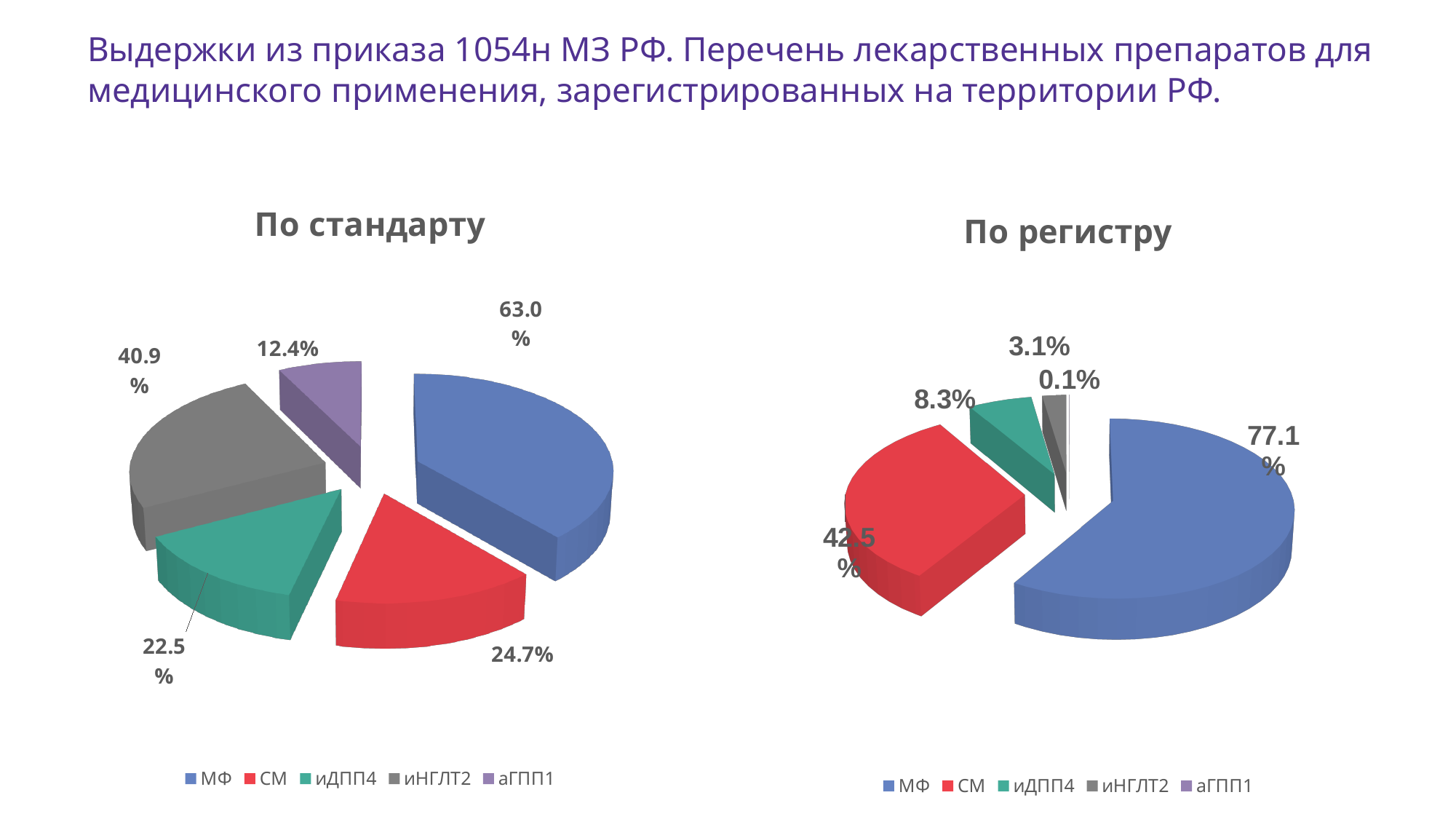
In the chart titled "По регистру", which category has the lowest value? аГПП1 In the chart titled "По регистру", what is the value for аГПП1? 0.1% In the chart titled "По стандарту", which category has the highest value? МФ What kind of chart is the chart titled "По стандарту"? Pie chart In the chart titled "По регистру", what is the value for СМ? 42.5% In the chart titled "По регистру", what is the difference between the values for МФ and СМ? 34.6% In the chart titled "По стандарту", which category has the lowest value? аГПП1 How many categories does the chart titled "По регистру" show? 5 In the chart titled "По стандарту", what is the value for иНГЛТ2? 40.9% In the chart titled "По стандарту", which is larger, the value for СМ or the value for иДПП4? СМ In the chart titled "По регистру", what colour is the slice for иДПП4? Green In the chart titled "По стандарту", what is the value for МФ? 63.0%